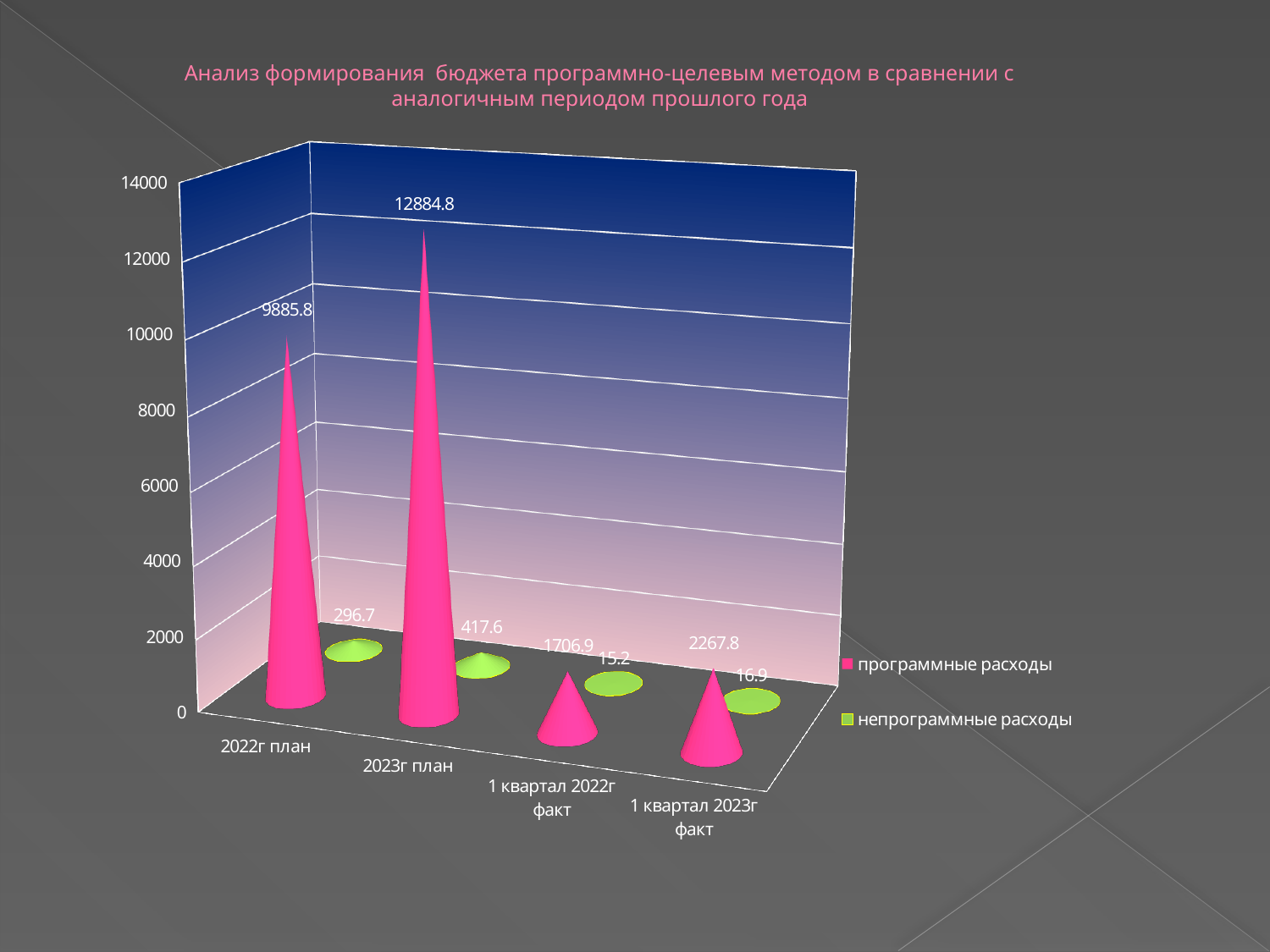
What is the value of непрограммные расходы for 2022г план? 296.7 What is the value of программные расходы for 2023г план? 12884.8 How many categories are shown on the x axis? 4 What kind of chart is shown on the slide? bar chart Which category has the highest value for программные расходы? 2023г план What is the value of программные расходы for 1 квартал 2022г факт? 1706.9 How many series does the legend list? 2 What is the difference between программные расходы for 2023г план and 2022г план? 2999.0 Which is larger: непрограммные расходы for 2023г план or for 2022г план? 2023г план Which category has the lowest value for непрограммные расходы? 1 квартал 2022г факт What is the value of непрограммные расходы for 1 квартал 2023г факт? 16.9 What colour represents непрограммные расходы in the legend? green